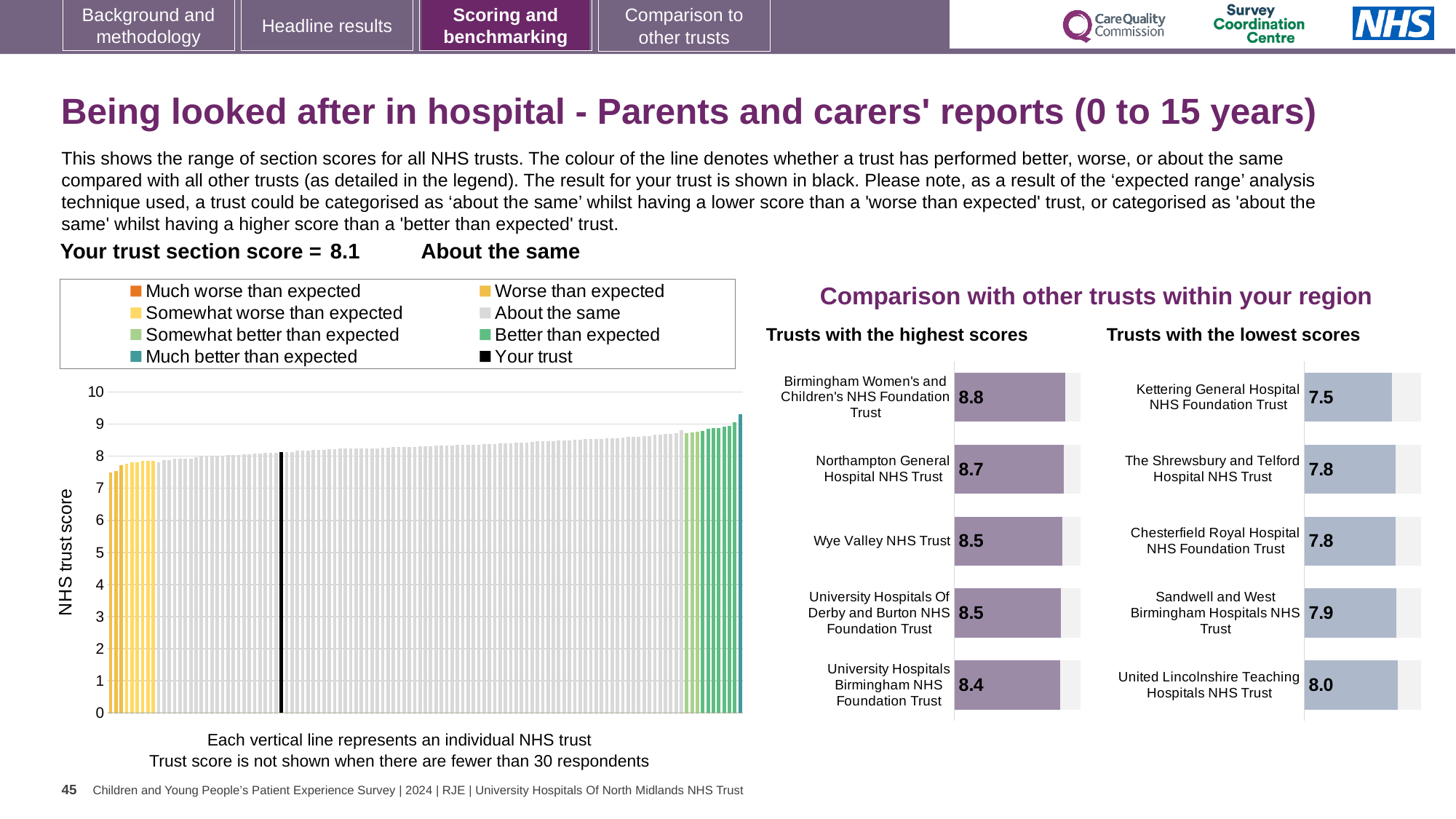
Which is larger: the score for Northampton General Hospital NHS Trust in the highest scores chart or the score for Kettering General Hospital NHS Foundation Trust in the lowest scores chart? Northampton General Hospital NHS Trust In the 'Trusts with the lowest scores' chart, what is the difference between the scores of United Lincolnshire Teaching Hospitals NHS Trust and Kettering General Hospital NHS Foundation Trust? 0.5 In the 'Trusts with the highest scores' chart, what is the difference between the scores of Birmingham Women's and Children's NHS Foundation Trust and University Hospitals Birmingham NHS Foundation Trust? 0.4 In the 'Trusts with the lowest scores' chart, what is the score for United Lincolnshire Teaching Hospitals NHS Trust? 8.0 In the 'Trusts with the highest scores' chart, what is the score for Wye Valley NHS Trust? 8.5 How many trusts are shown in the 'Trusts with the lowest scores' chart? 5 How many entries does the legend of the large chart on the left list? 8 In the 'Trusts with the highest scores' chart, what is the score for Birmingham Women's and Children's NHS Foundation Trust? 8.8 In the large chart on the left showing the range of section scores, do the trust scores rise or fall from left to right along the x axis? rise In the 'Trusts with the lowest scores' chart, what is the score for Kettering General Hospital NHS Foundation Trust? 7.5 In the 'Trusts with the highest scores' chart, which trust has the lowest score? University Hospitals Birmingham NHS Foundation Trust In the 'Trusts with the lowest scores' chart, which trust has the highest score? United Lincolnshire Teaching Hospitals NHS Trust